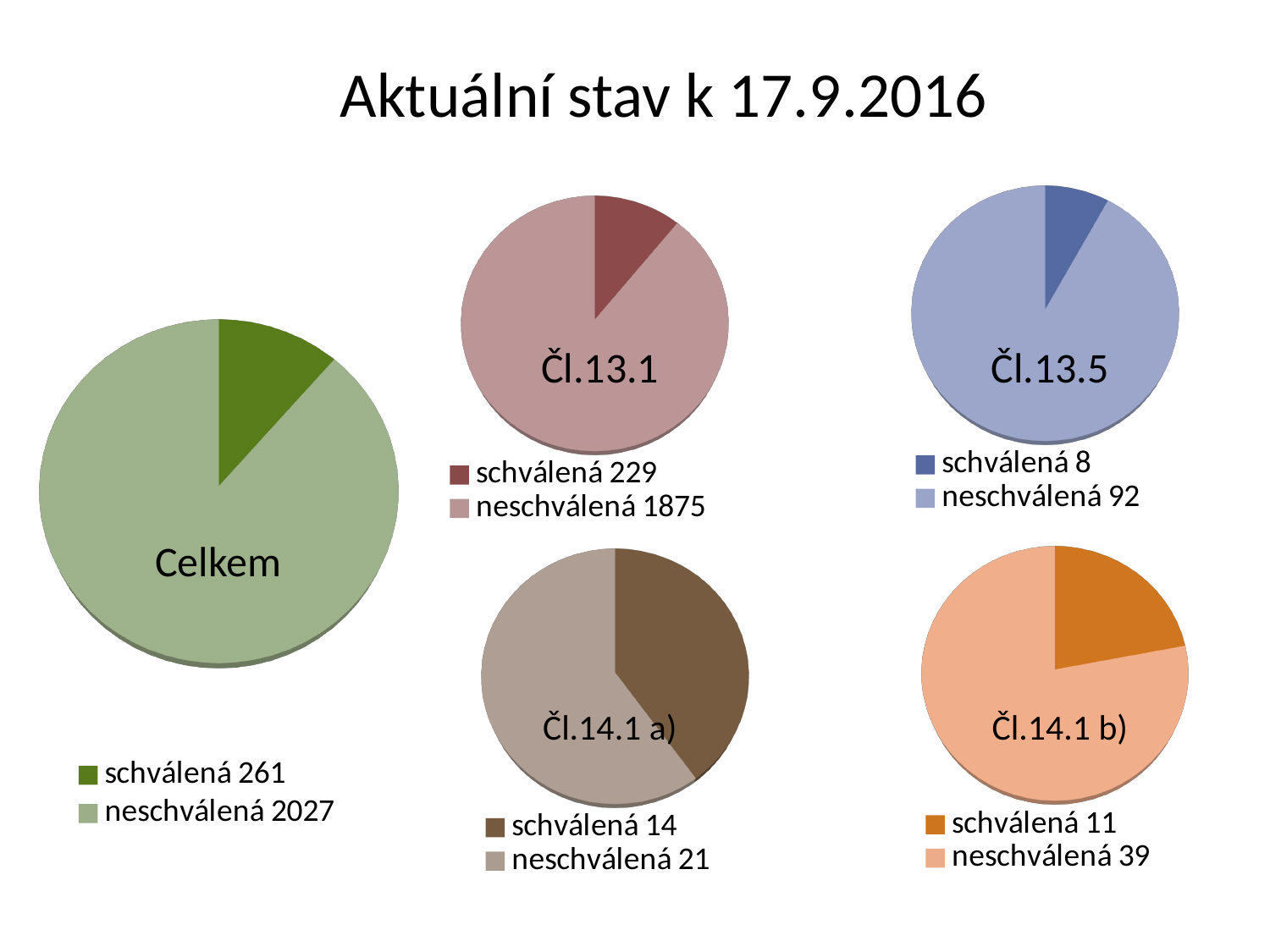
In the Čl.14.1 b) pie chart, what is the difference between neschválená and schválená? 28 In the Čl.14.1 a) pie chart, what share of the total does schválená represent? 40% In the Čl.13.5 pie chart, what share of the total does schválená represent? 8% In the Celkem pie chart, what is the value for schválená? 261 In the Čl.13.1 pie chart, what is the value for neschválená? 1875 How many pie charts are shown on the slide? 5 What type of chart is the Čl.13.1 chart? pie chart In the Čl.14.1 a) pie chart, which category is larger, schválená or neschválená? neschválená In the Čl.14.1 b) pie chart, what is the value for schválená? 11 In the Čl.13.5 pie chart, what is the value for schválená? 8 In the Čl.14.1 a) pie chart, what is the value for neschválená? 21 In the Celkem pie chart, what is the difference between neschválená and schválená? 1766